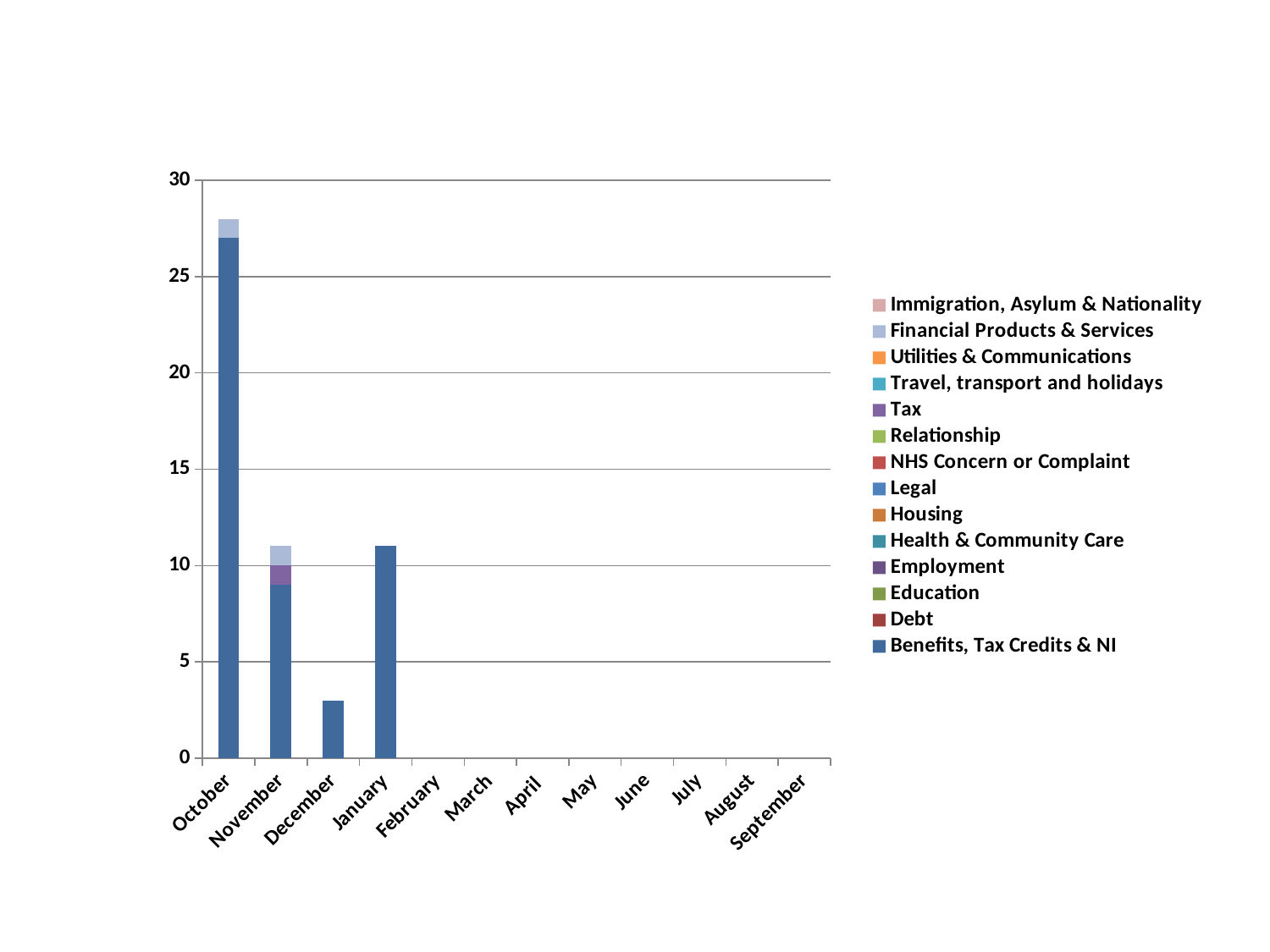
Is the total value for December greater or less than 5? less Which series makes up the largest part of the October bar? Benefits, Tax Credits & NI Do the bars rise or fall from October to December? fall Which is larger, the bar for October or the bar for November? October Which month has the tallest bar? October How many series does the legend list? 14 Which is larger, the bar for December or the bar for January? January Is the total value for October greater or less than 25? greater Which month is the first on the x axis? October What kind of chart is shown on the slide? Stacked bar chart Is the total value for January greater or less than 10? greater How many months are shown along the x axis? 12